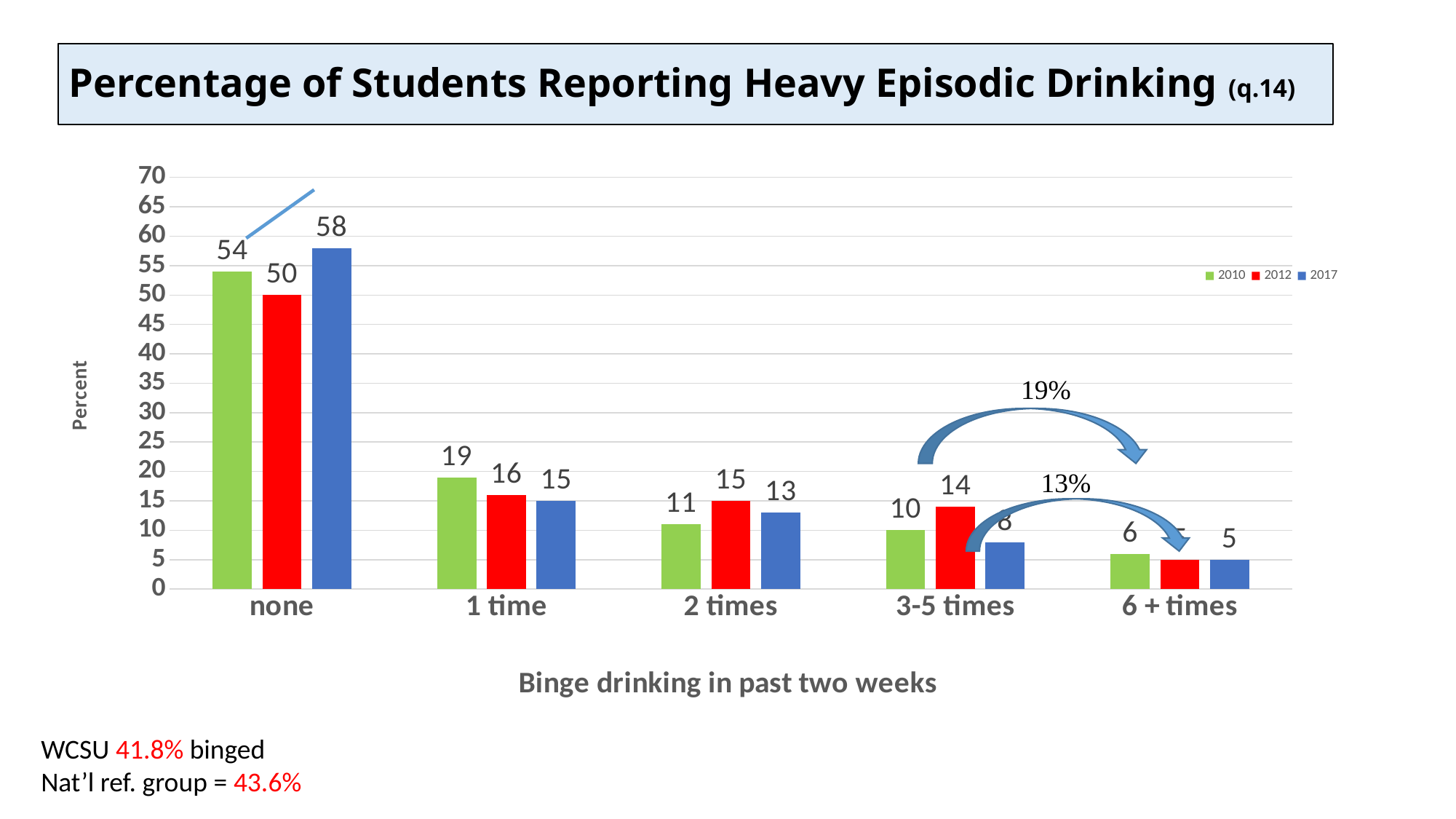
Which year has the highest value in the 'none' category? 2017 What is the difference between the 2017 and 2012 values in the 'none' category? 8 What is the value for 2012 in the '2 times' category? 15 Is the value for 2017 in the '3-5 times' category greater or less than 10? less What type of chart is shown on the slide? bar chart Which year has the lowest value in the '1 time' category? 2017 What is the value for 2017 in the 'none' category? 58 How many categories are shown on the x axis? 5 How many series does the legend list? 3 What is the label of the y axis? Percent What is the value for 2010 in the '1 time' category? 19 Which is larger in the '3-5 times' category: the 2010 value or the 2012 value? 2012